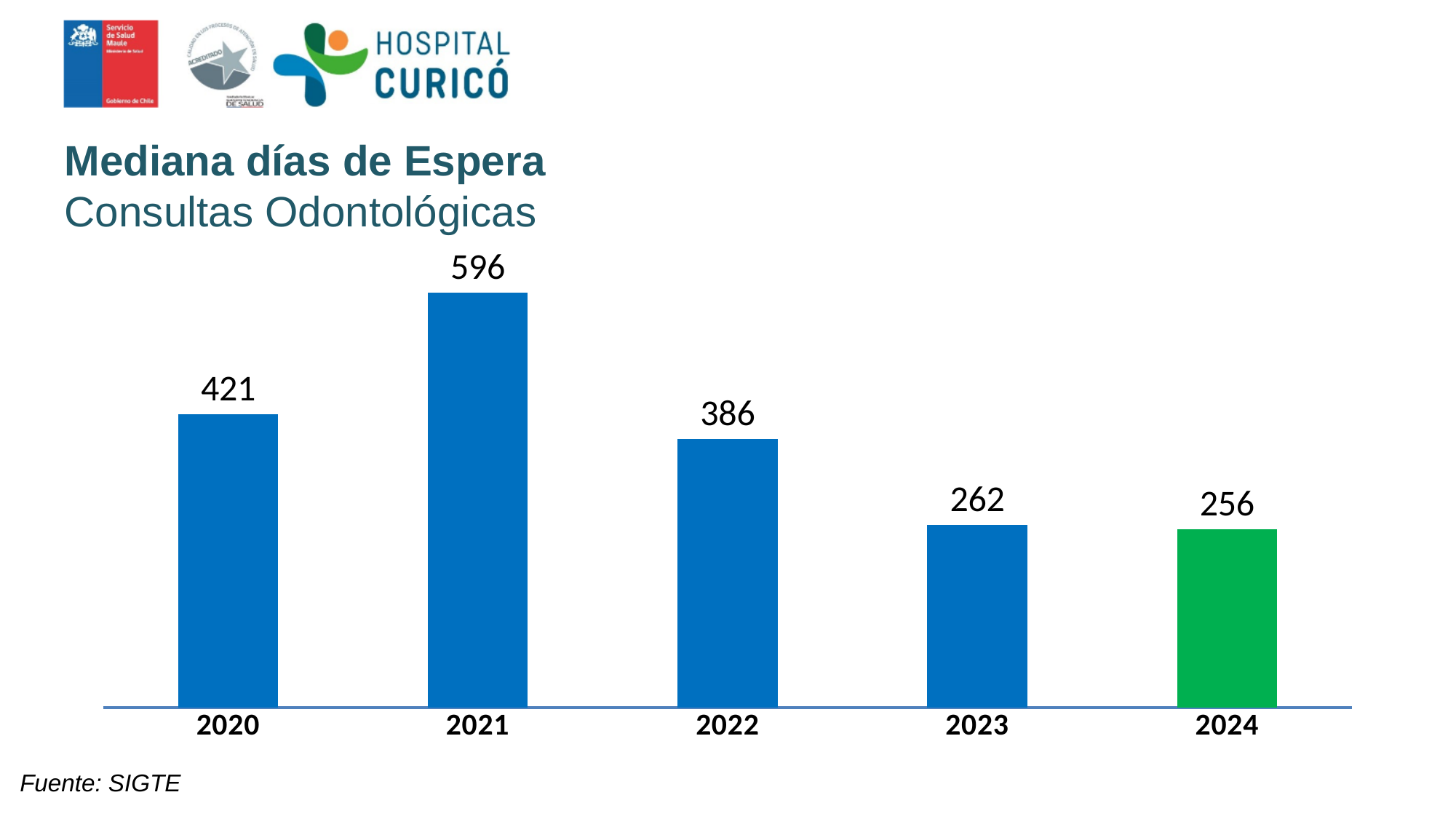
What is the median waiting days value for 2021? 596 What kind of chart is shown on the slide? Bar chart How many years are shown on the chart? 5 Do the values rise or fall from 2021 to 2024? Fall What is the difference between the values for 2023 and 2024? 6 Which year has the highest median waiting days? 2021 Which is larger, the value for 2020 or the value for 2022? 2020 Which bar is coloured green instead of blue? 2024 What is the value shown for 2020? 421 What is the difference between the values for 2021 and 2022? 210 Which year has the lowest median waiting days? 2024 What is the value shown for 2024? 256